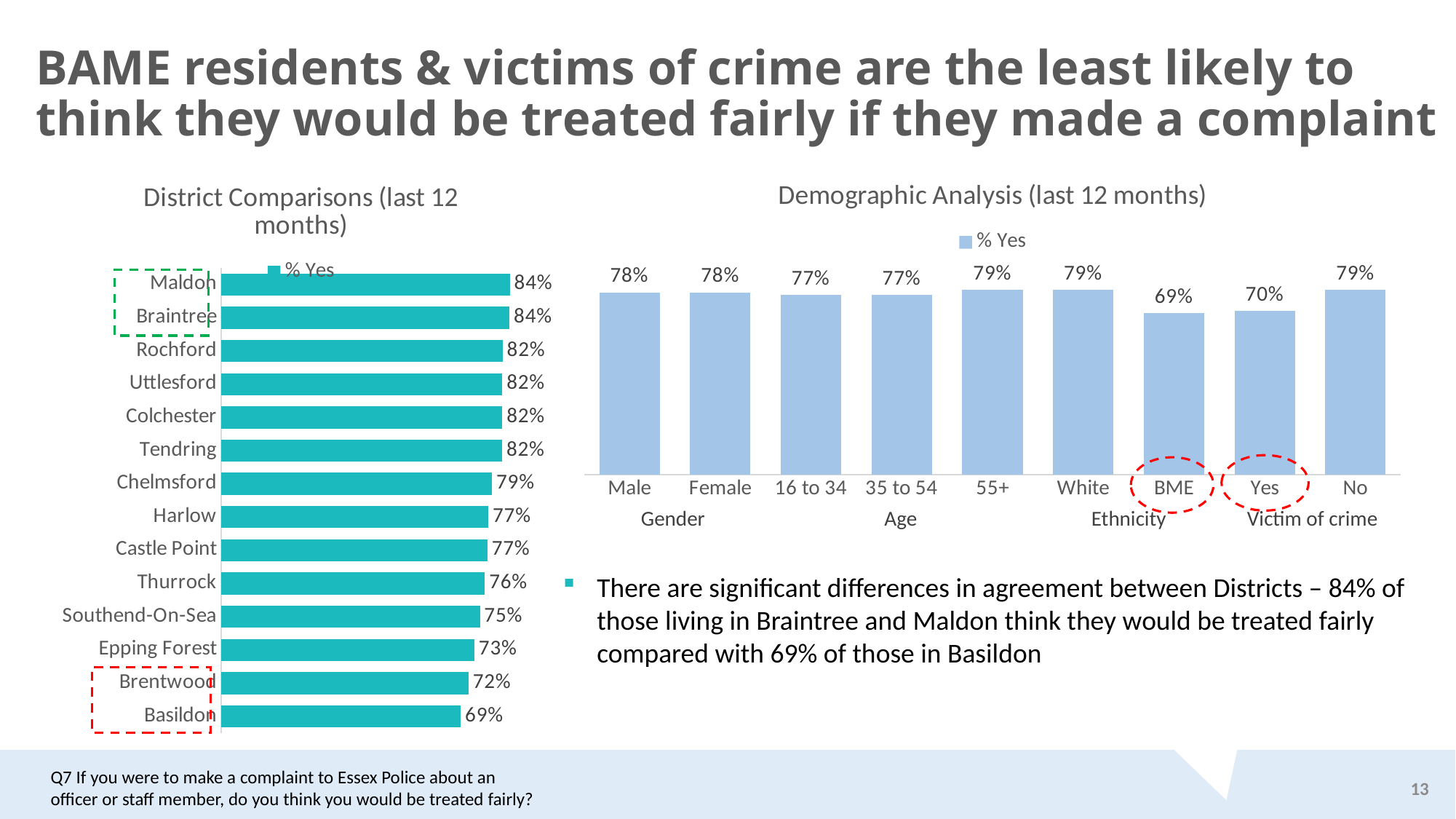
In the Demographic Analysis chart, what is the difference between the values for White and BME? 10% In the District Comparisons chart, which is larger, the value for Harlow or the value for Epping Forest? Harlow In the Demographic Analysis chart, what is the % Yes value for BME? 69% In the District Comparisons chart, which district has the lowest % Yes value? Basildon In the District Comparisons chart, what is the difference between the values for Maldon and Basildon? 15% In the District Comparisons chart, how many districts are shown? 14 In the District Comparisons chart, what is the % Yes value for Southend-On-Sea? 75% In the Demographic Analysis chart, what series name does the legend show? % Yes What type of chart is the Demographic Analysis chart? Bar chart In the District Comparisons chart, what is the % Yes value for Chelmsford? 79% In the Demographic Analysis chart, which category has the lowest % Yes value? BME In the Demographic Analysis chart, how many categories are plotted? 9